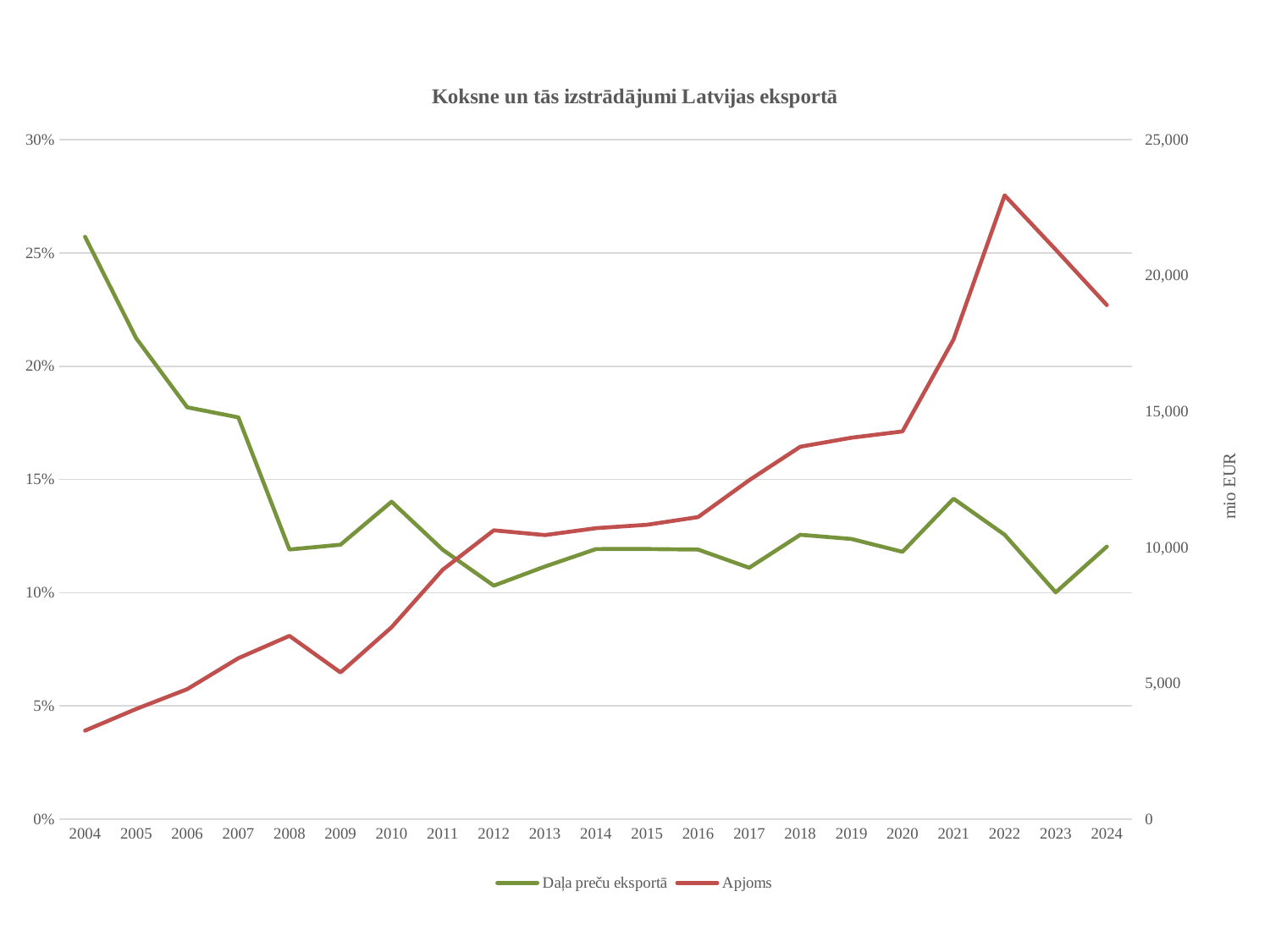
How many years are plotted along the x axis? 21 Which year has the higher 'Daļa preču eksportā' value, 2010 or 2012? 2010 What kind of chart is shown on the slide? line chart What is the title of the chart? Koksne un tās izstrādājumi Latvijas eksportā In which year is the 'Daļa preču eksportā' series at its highest? 2004 In which year is the 'Daļa preču eksportā' series at its lowest? 2023 Is the 'Apjoms' value for 2022 greater or less than 20,000? greater Is the 'Daļa preču eksportā' value for 2008 greater or less than 15%? less How many series does the legend list? 2 In which year does the 'Apjoms' series reach its highest value? 2022 In which year is the 'Apjoms' series at its lowest? 2004 Does the 'Apjoms' series rise or fall between 2016 and 2022? rise